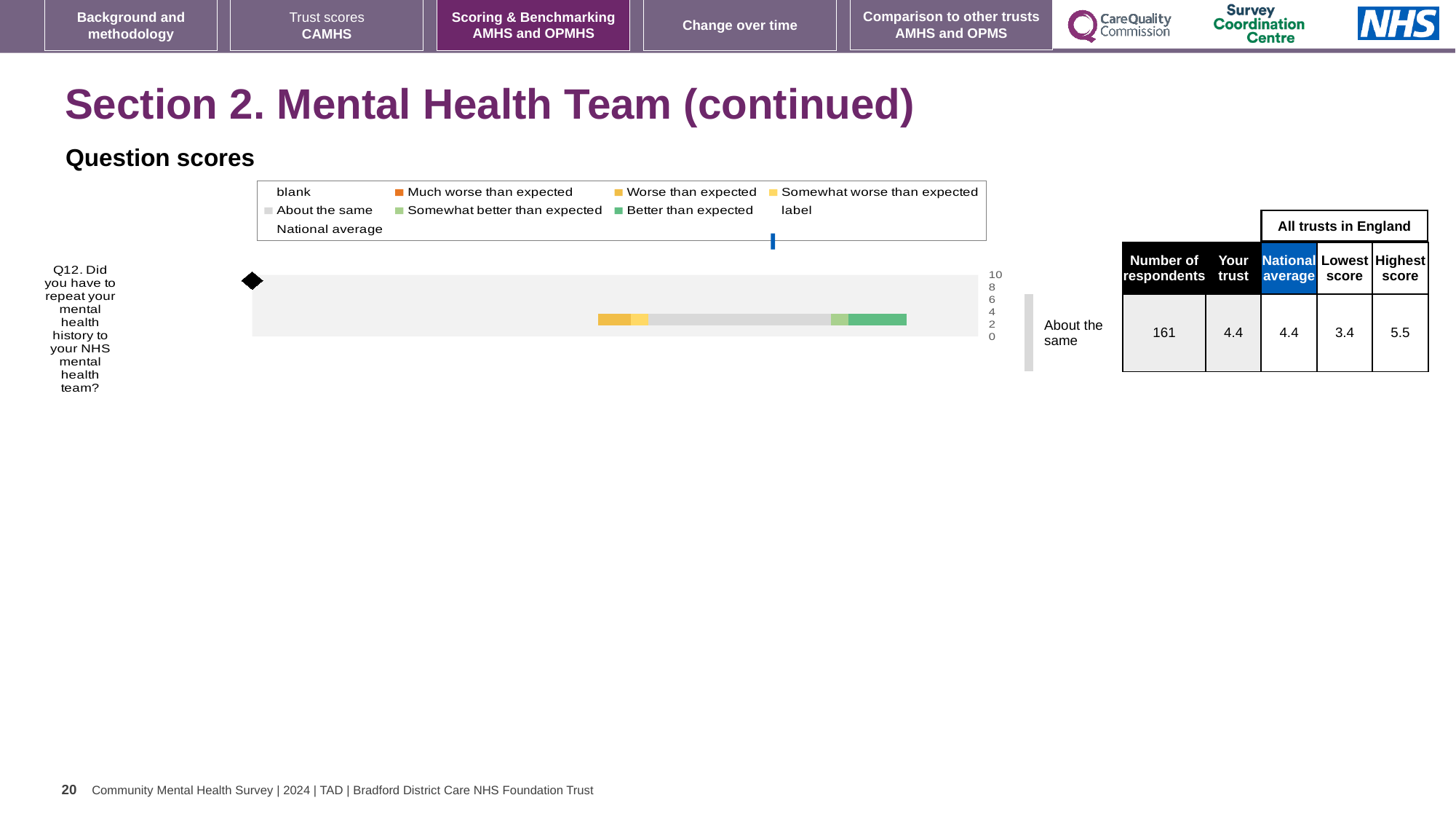
What is the highest tick value shown on the chart's axis? 10 Is the 'Your trust' score for Q12 greater or less than the lowest score? greater Which question is plotted on the chart? Q12. Did you have to repeat your mental health history to your NHS mental health team? How many survey questions are plotted on the chart? 1 What is the national average score for Q12? 4.4 What kind of chart is shown on the slide? bar chart What is the number of respondents for Q12? 161 What benchmark category is shown next to the bar for Q12? About the same What is the lowest score among all trusts in England for Q12? 3.4 What is the difference between the highest score and the lowest score for Q12? 2.1 What is the highest score among all trusts in England for Q12? 5.5 What is the 'Your trust' score for Q12? 4.4